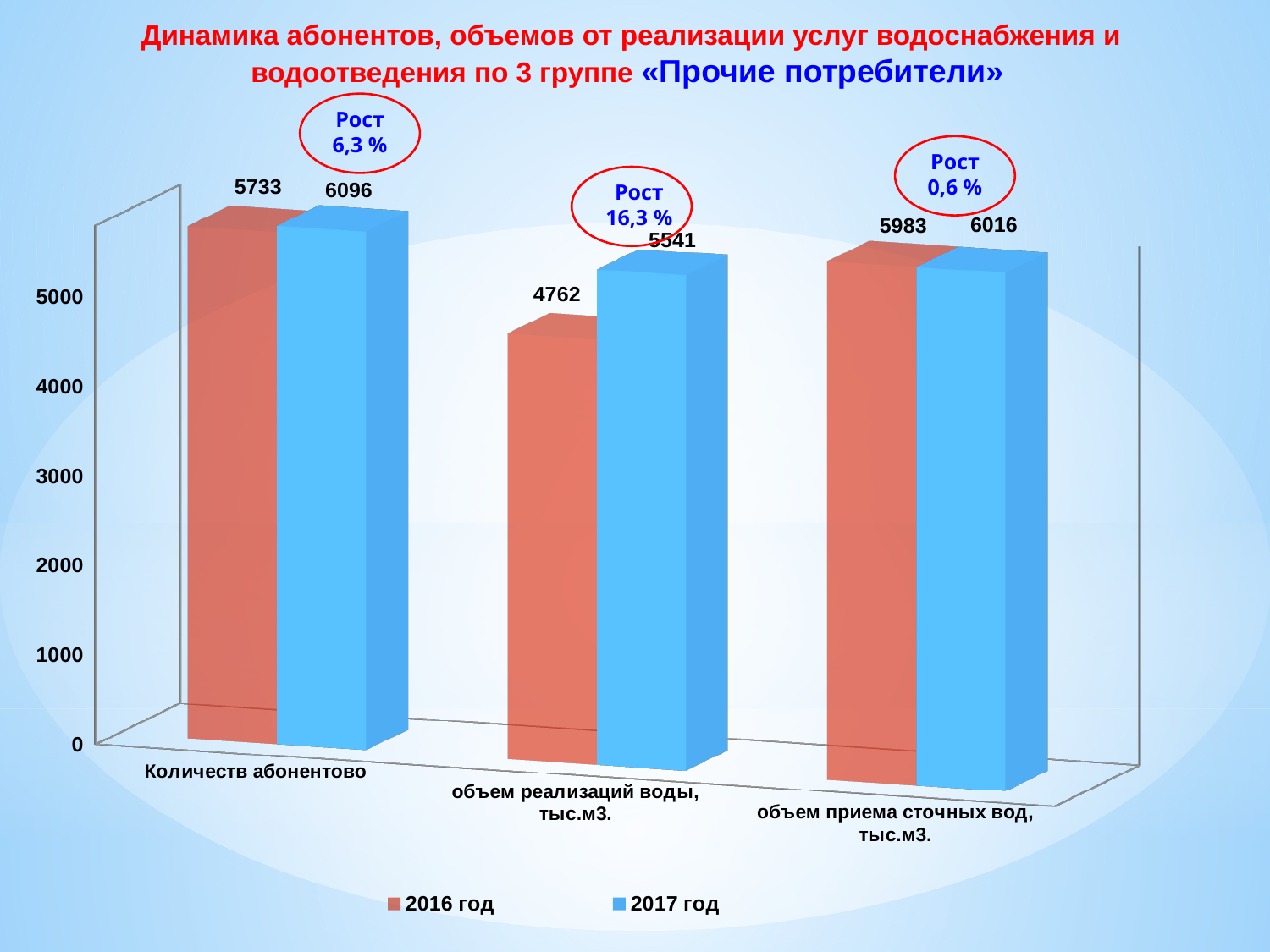
Which category has the lowest value for 2016 год? объем реализаций воды, тыс.м3. What is the value for 2017 год in the category Количеств абонентово? 6096 What is the value for 2016 год in the category Количеств абонентово? 5733 What kind of chart is shown on the slide? bar chart What is the value for 2017 год in the category объем реализаций воды, тыс.м3.? 5541 How many series does the legend list? 2 What is the value for 2016 год in the category объем приема сточных вод, тыс.м3.? 5983 Which is larger in the category объем приема сточных вод, тыс.м3.: the 2016 год value or the 2017 год value? 2017 год What is the difference between the 2017 год and 2016 год values in the category объем реализаций воды, тыс.м3.? 779 How many categories are shown on the x axis? 3 Is the value for 2016 год in the category объем реализаций воды, тыс.м3. greater or less than 5000? less What is the difference between the 2017 год and 2016 год values in the category Количеств абонентово? 363